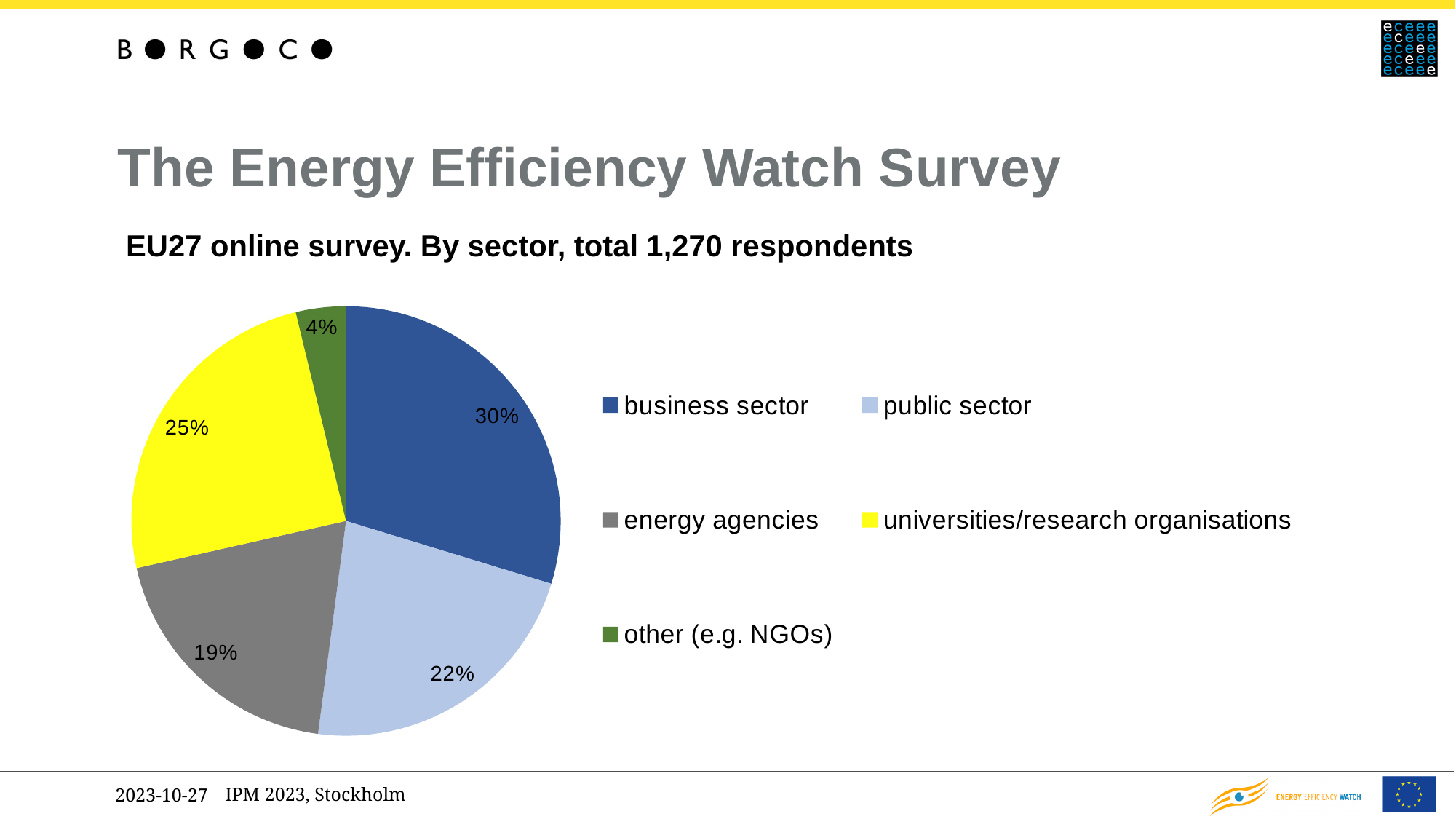
Which sector has the largest share of respondents? business sector What type of chart is shown on the slide? pie chart What colour represents universities/research organisations in the chart? yellow What share of respondents is from the public sector? 22% What share of respondents is in the 'other (e.g. NGOs)' category? 4% What share of respondents is from the business sector? 30% What share of respondents is from universities/research organisations? 25% What share of respondents is from energy agencies? 19% Which category has the smallest share of respondents? other (e.g. NGOs) Which has a larger share, energy agencies or universities/research organisations? universities/research organisations What is the difference in percentage points between the business sector and the public sector shares? 8 How many categories does the pie chart show? 5